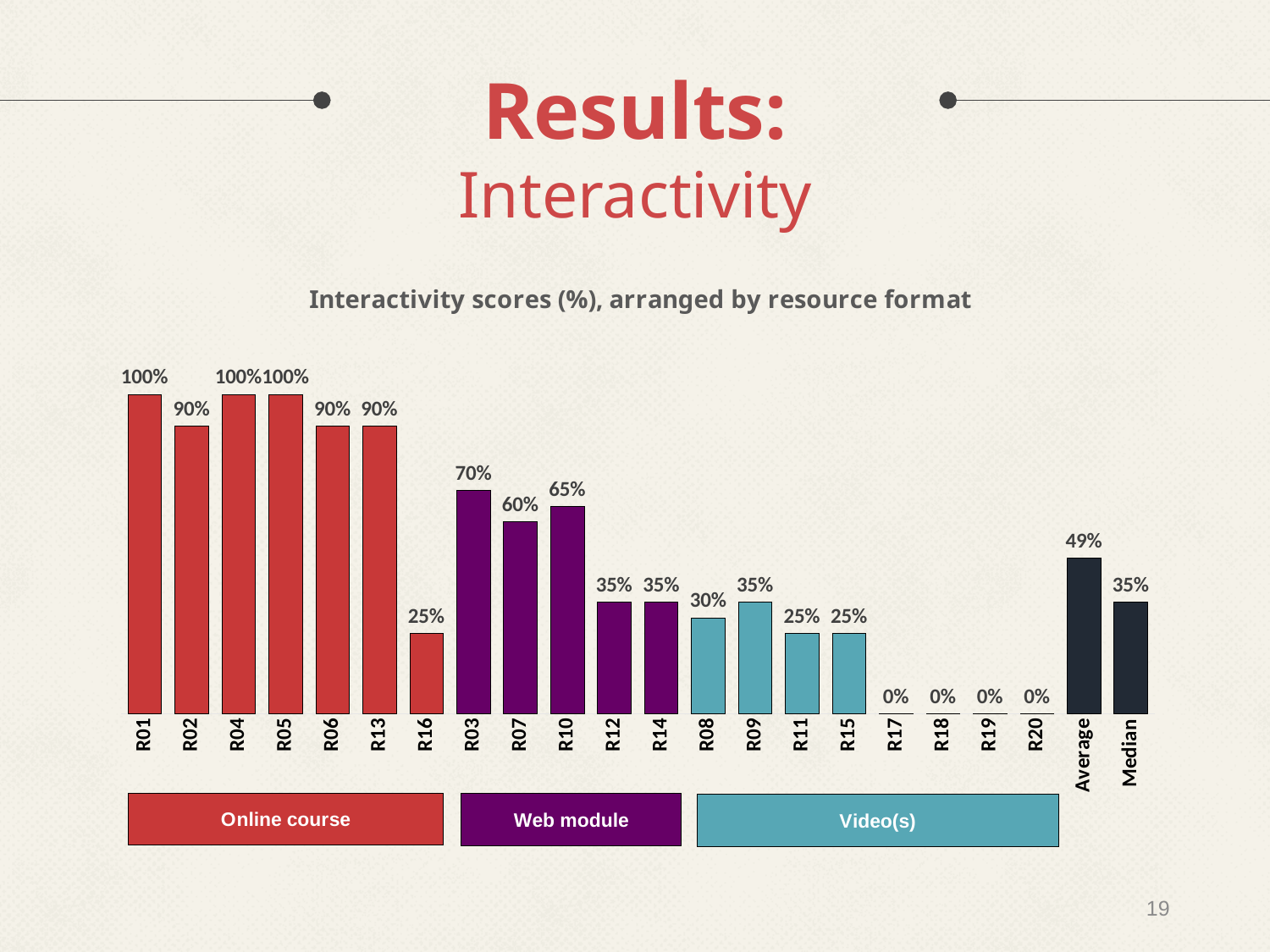
What type of chart is shown on the slide? Bar chart Which resource in the Online course group has the lowest interactivity score? R16 What is the Median interactivity score shown on the chart? 35% How many resources are in the Video(s) group? 8 What is the interactivity score for R03? 70% What is the difference between the interactivity scores of R03 and R07? 10% What is the difference between the Average and Median interactivity scores? 14% What is the Average interactivity score shown on the chart? 49% How many resources have an interactivity score of 0%? 4 Which resource in the Web module group has the highest interactivity score? R03 Which has a higher interactivity score, R10 or R07? R10 What is the interactivity score for R16? 25%